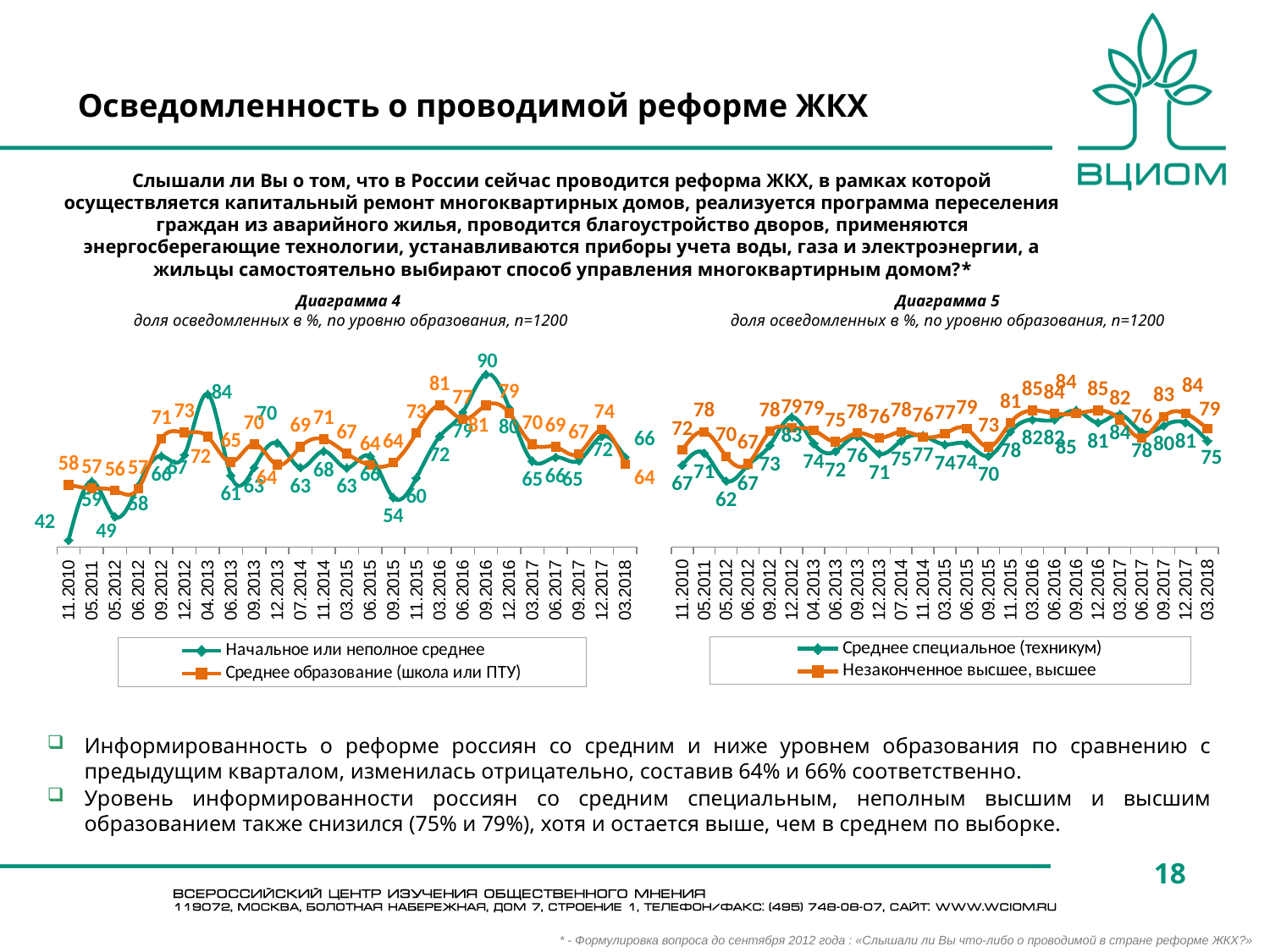
In Диаграмма 5 (right chart), what is the value for 'Незаконченное высшее, высшее' at 03.2018? 79 How many dates are shown on the x axis of Диаграмма 5 (right chart)? 25 In Диаграмма 5 (right chart), which series has the larger value at 03.2018? Незаконченное высшее, высшее In Диаграмма 4 (left chart), what is the highest value reached by 'Начальное или неполное среднее'? 90 In Диаграмма 5 (right chart), what is the lowest value of 'Среднее специальное (техникум)'? 62 In Диаграмма 4 (left chart), what is the value for 'Среднее образование (школа или ПТУ)' at 03.2018? 64 What kind of chart is Диаграмма 4 on the left of the slide? Line chart In Диаграмма 4 (left chart), at which date does 'Начальное или неполное среднее' have its lowest value? 11.2010 In Диаграмма 4 (left chart), what is the value for 'Начальное или неполное среднее' at 03.2018? 66 In Диаграмма 4 (left chart), what is the difference between 'Среднее образование (школа или ПТУ)' and 'Начальное или неполное среднее' at 03.2018? 2 In Диаграмма 5 (right chart), what is the value for 'Среднее специальное (техникум)' at 03.2018? 75 How many series does the legend of Диаграмма 4 (left chart) list? 2